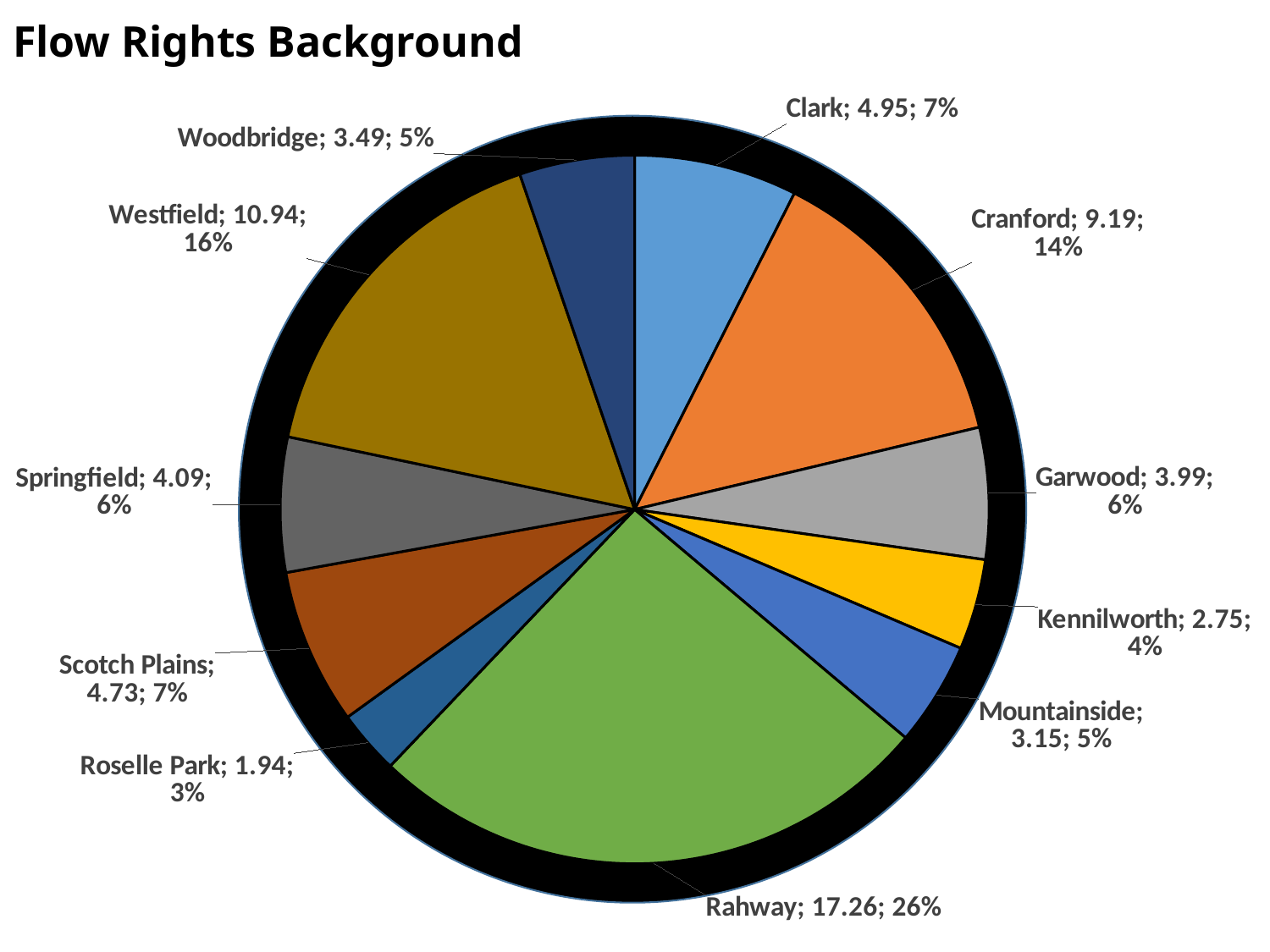
What share of the pie does Scotch Plains represent? 7% What is the title of the slide? Flow Rights Background What kind of chart is shown on the slide? pie chart What is the value for Kennilworth? 2.75 How many slices does the pie chart have? 11 Which is larger, the value for Clark or the value for Garwood? Clark What is the value for Westfield? 10.94 Which category has the smallest slice? Roselle Park What is the value for Rahway? 17.26 What is the difference between the values for Rahway and Westfield? 6.32 What share of the pie does Cranford represent? 14% Which category has the largest slice? Rahway